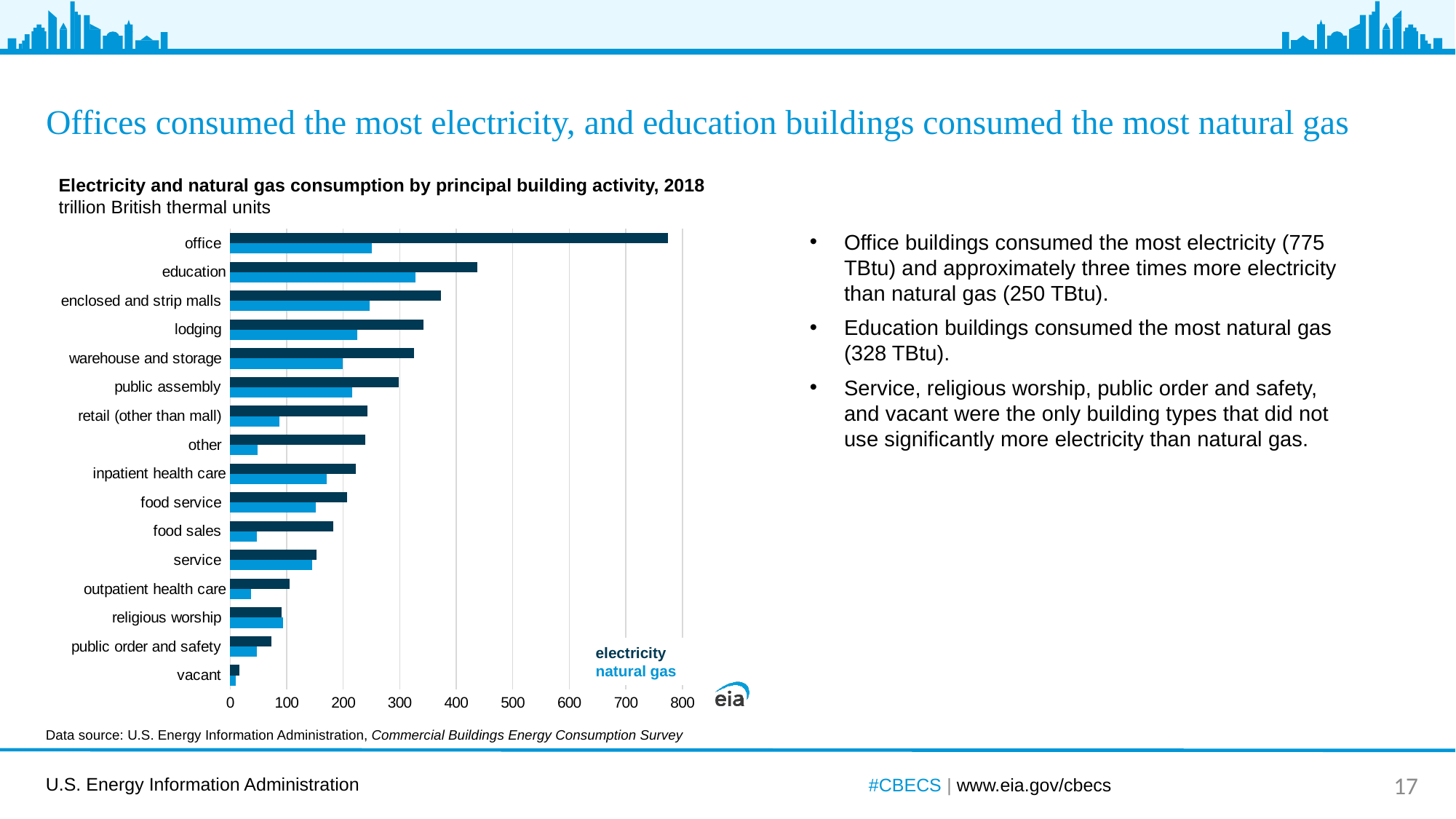
How many building activity categories are plotted in the chart? 16 Is the electricity value for education greater or less than 400? greater Which building activity has the lowest electricity consumption in the chart? vacant Which series is shown in the dark navy colour in the chart? electricity What type of chart is shown on the slide? bar chart Which building activity consumed the most electricity? office How much electricity did office buildings consume, according to the slide? 775 TBtu Which building activity consumed the most natural gas? education What is the difference between office buildings' electricity consumption (775 TBtu) and their natural gas consumption (250 TBtu)? 525 TBtu How many series does the chart's legend list? 2 Is the natural gas value for food sales greater or less than 100? less How much natural gas did education buildings consume, according to the slide? 328 TBtu